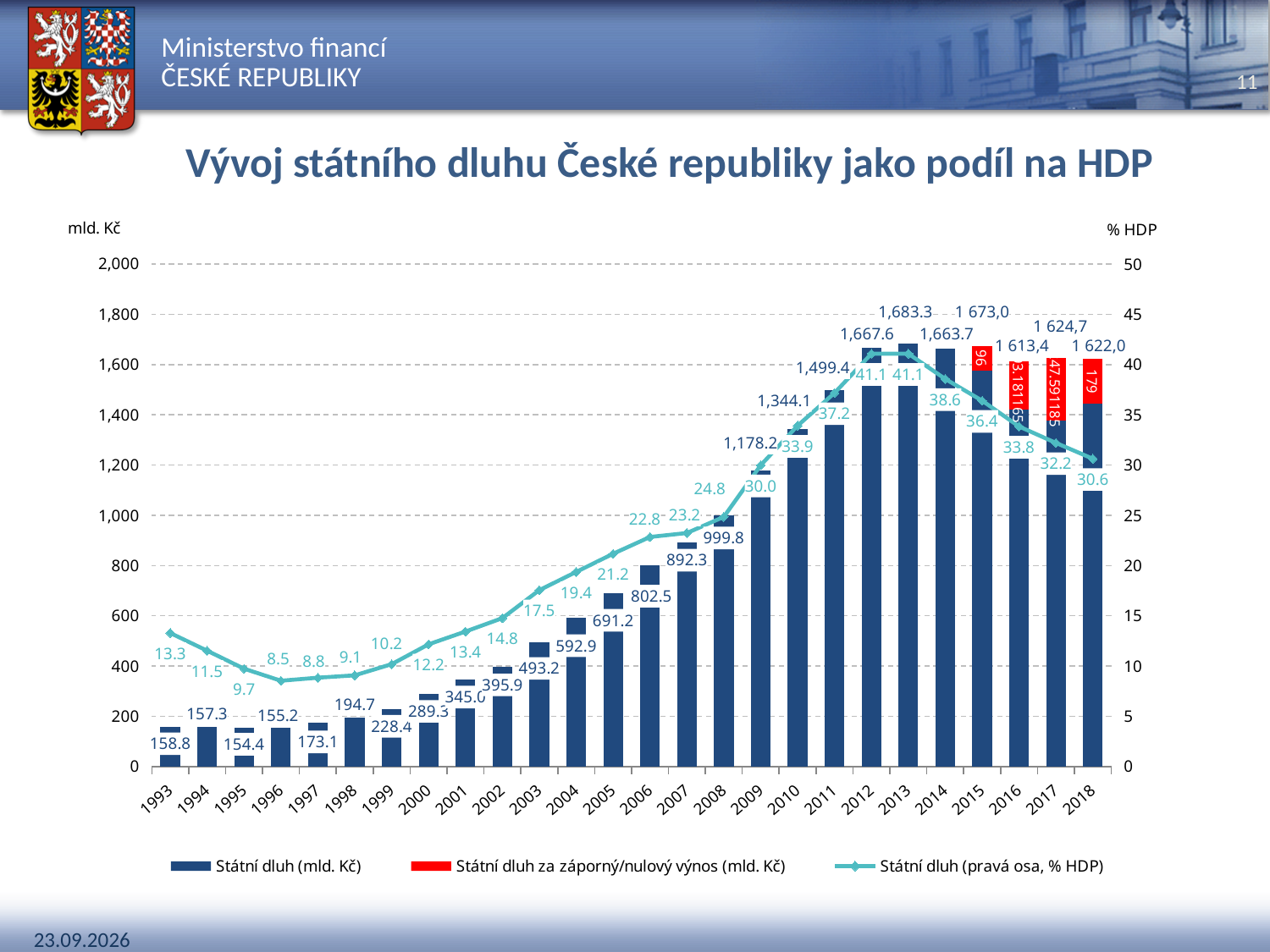
Does Státní dluh as % HDP rise or fall from 2013 to 2018? Fall What is the difference between Státní dluh (mld. Kč) in 2009 and in 2008? 178.4 What is the label of the right-hand axis? % HDP How many years are shown on the x axis? 26 What is the Státní dluh as % HDP (right axis) for 2012? 41.1 What kind of chart is shown on the slide? Combined bar and line chart How many series does the legend list? 3 What is the value of Státní dluh (mld. Kč) for 2008? 999.8 Which year has the larger Státní dluh (mld. Kč), 1993 or 1994? 1993 What is the value of Státní dluh za záporný/nulový výnos (mld. Kč) for 2018? 179 In which year is Státní dluh (mld. Kč) the highest? 2013 In which year is Státní dluh as % HDP the lowest? 1996